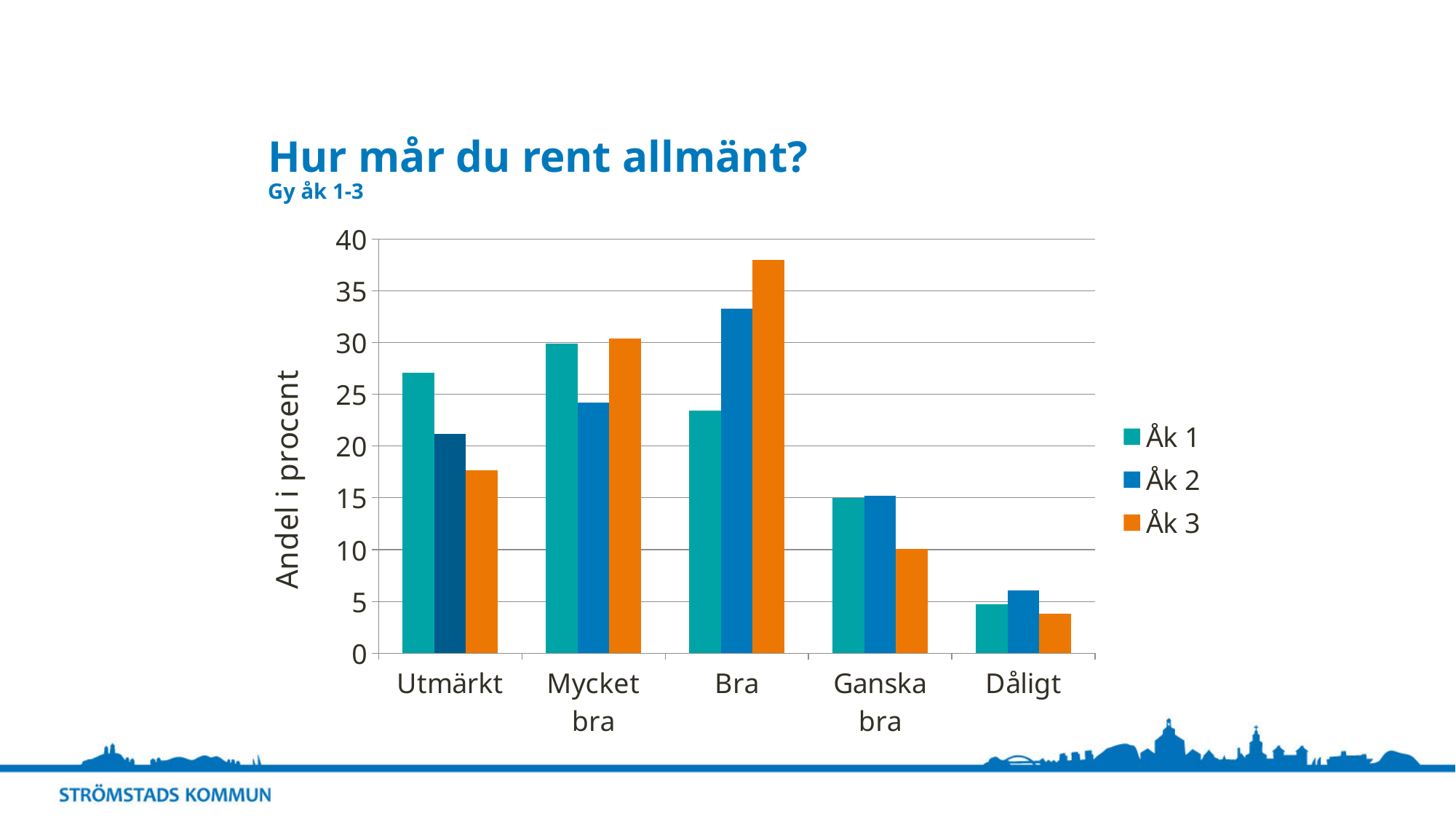
For Dåligt, which is larger: the Åk 2 value or the Åk 3 value? Åk 2 For which category is the Åk 1 bar lowest? Dåligt How many categories are shown on the x axis? 5 For which category is the Åk 3 bar highest? Bra What is the title of the vertical axis? Andel i procent Is the Åk 3 value for Utmärkt greater or less than 20? less For Utmärkt, which is larger: the Åk 1 value or the Åk 3 value? Åk 1 For which category is the Åk 2 bar highest? Bra What kind of chart is shown on the slide? bar chart Is the Åk 1 value for Utmärkt greater or less than 25? greater Is the Åk 3 value for Bra greater or less than 35? greater How many series does the legend list? 3